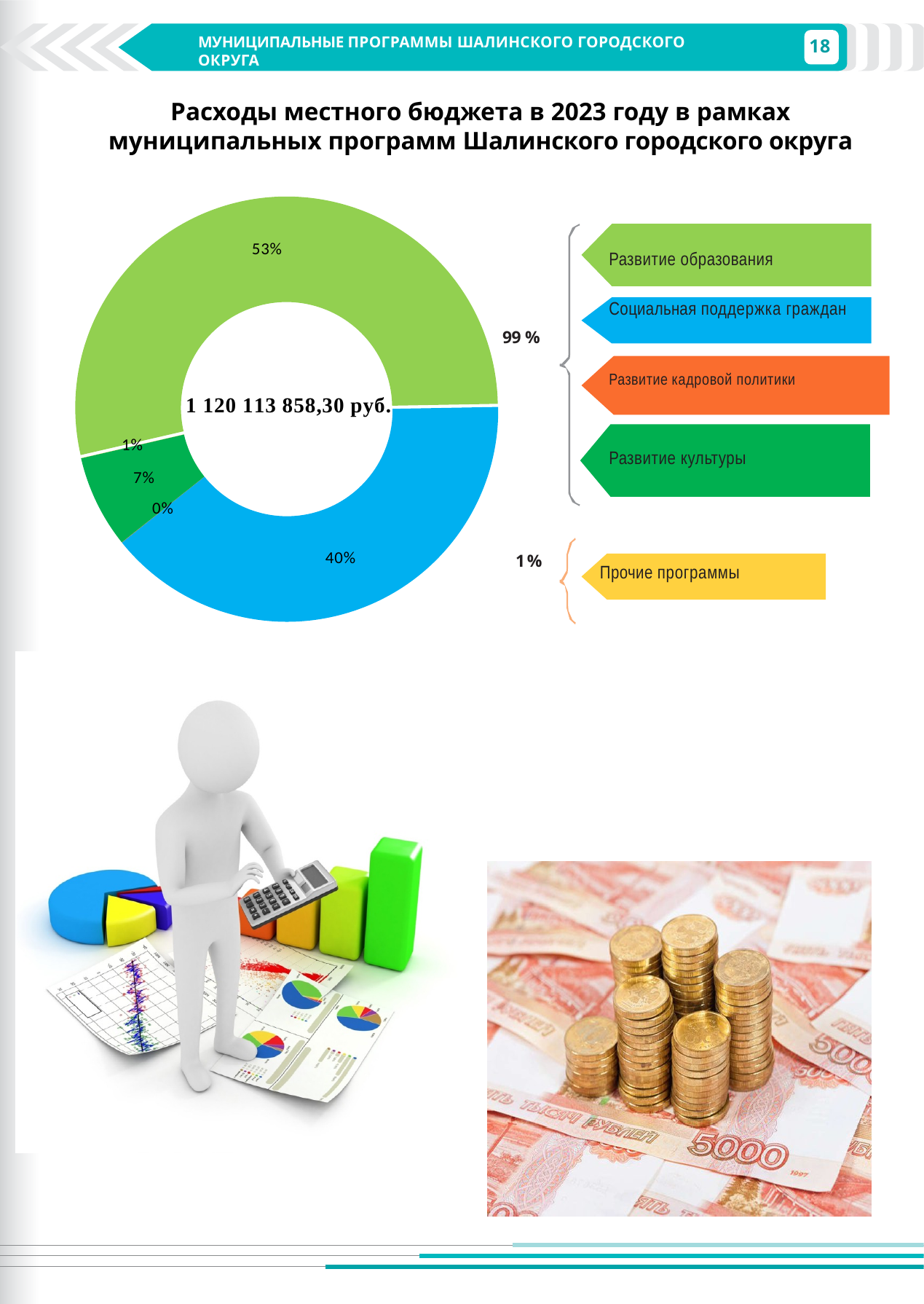
What share of the local budget expenditure goes to Прочие программы? 1% Which has a larger share: Развитие культуры or Социальная поддержка граждан? Социальная поддержка граждан What share of the local budget expenditure goes to Развитие культуры? 7% What is the difference in percentage points between the shares of Развитие образования and Социальная поддержка граждан? 13 percentage points Which program has the smallest share of the expenditure? Развитие кадровой политики What share of the local budget expenditure goes to Социальная поддержка граждан? 40% What kind of chart is shown on the slide? Pie (donut) chart How many programs are listed in the legend of the chart? 5 What total amount is shown in the centre of the donut chart? 1 120 113 858,30 руб. Which program has the largest share of the expenditure? Развитие образования What combined percentage is shown next to the bracket grouping the first four programs? 99 %